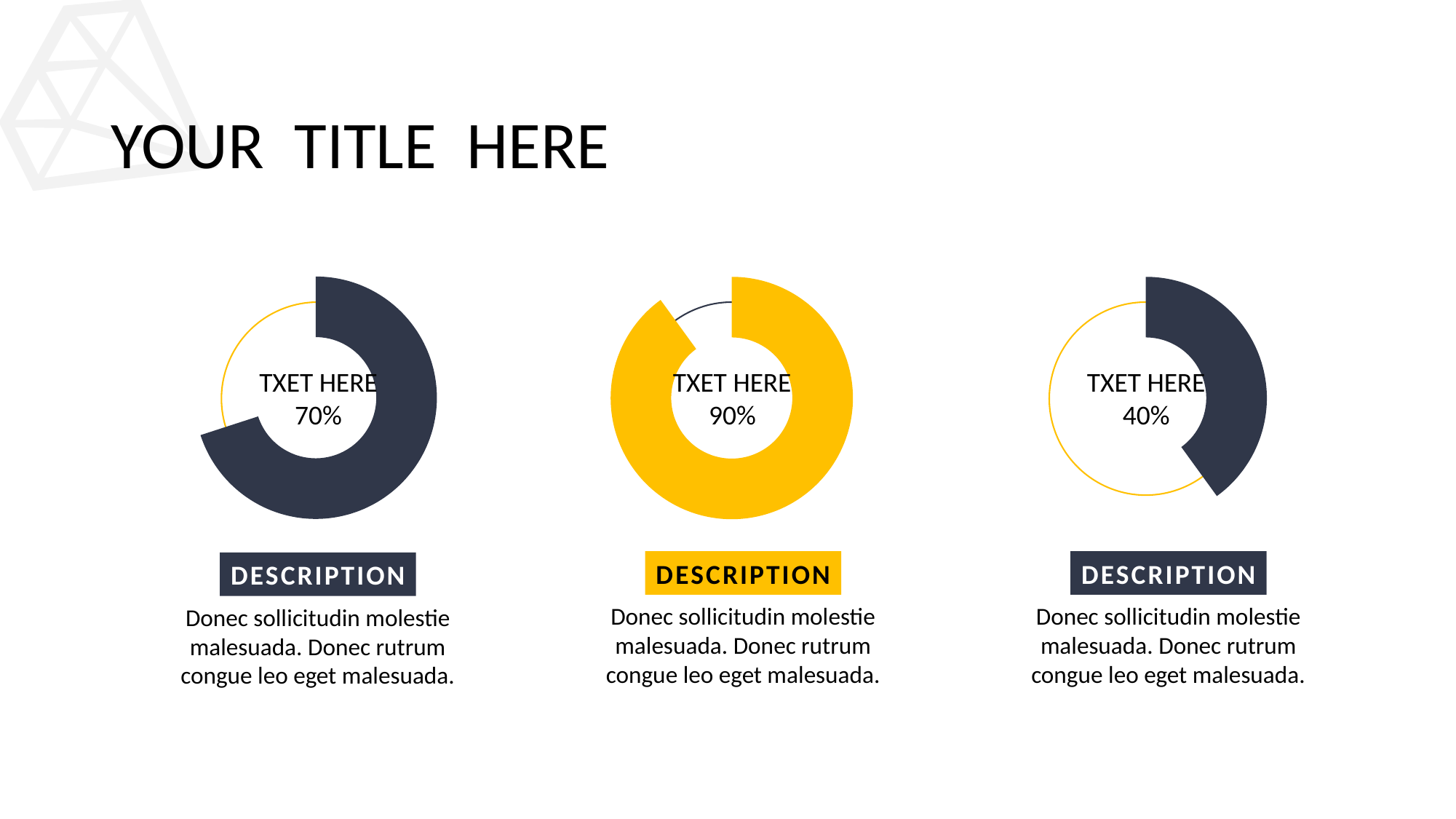
What is the difference between the percentage in the left chart and the percentage in the right chart? 30% Which of the three donut charts shows the highest percentage? The middle chart (90%) What percentage is shown in the left donut chart? 70% What is the difference between the percentage in the middle chart and the percentage in the right chart? 50% What colour is the filled ring of the middle donut chart? Yellow What kind of chart is used to display the percentages on this slide? Donut chart Which shows a larger percentage, the left chart or the right chart? The left chart Which of the three donut charts shows the lowest percentage? The right chart (40%) What percentage is shown in the right donut chart? 40% How many donut charts are on the slide? 3 What percentage is shown in the middle donut chart? 90% What is the difference between the percentage in the middle chart and the percentage in the left chart? 20%